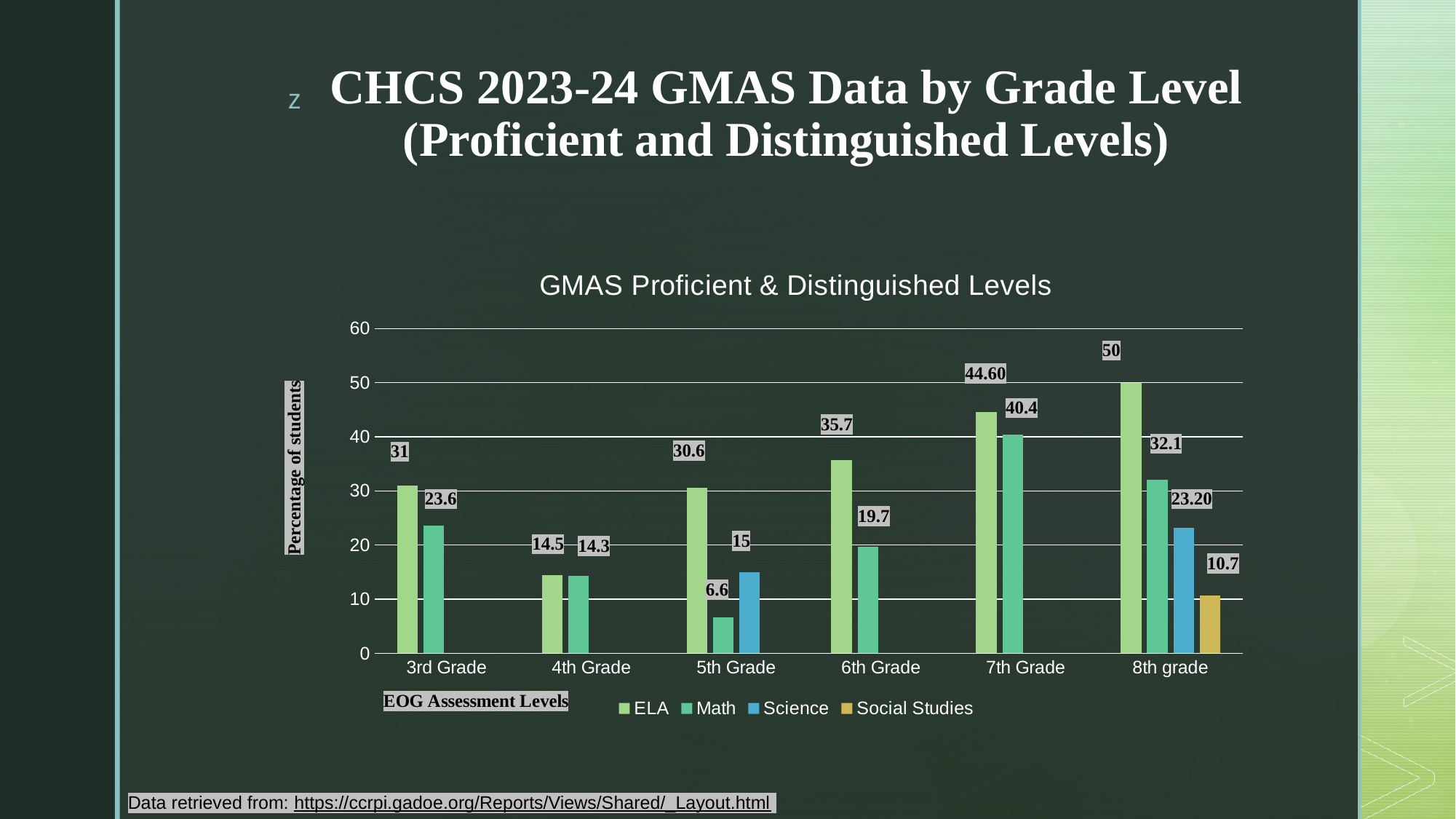
What is the Social Studies value for 8th grade? 10.7 How many series does the legend list? 4 What is the ELA value for 8th grade? 50 Which grade has the lowest Math value? 5th Grade What type of chart is shown on the slide? bar chart What is the Science value for 8th grade? 23.20 What is the difference between the ELA and Math values for 6th Grade? 16 Which is larger for 7th Grade, the ELA value or the Math value? ELA Which grade has the highest ELA value? 8th grade How many grade levels are shown on the x axis? 6 Is the ELA value for 3rd Grade greater or less than 40? less What is the Math value for 5th Grade? 6.6